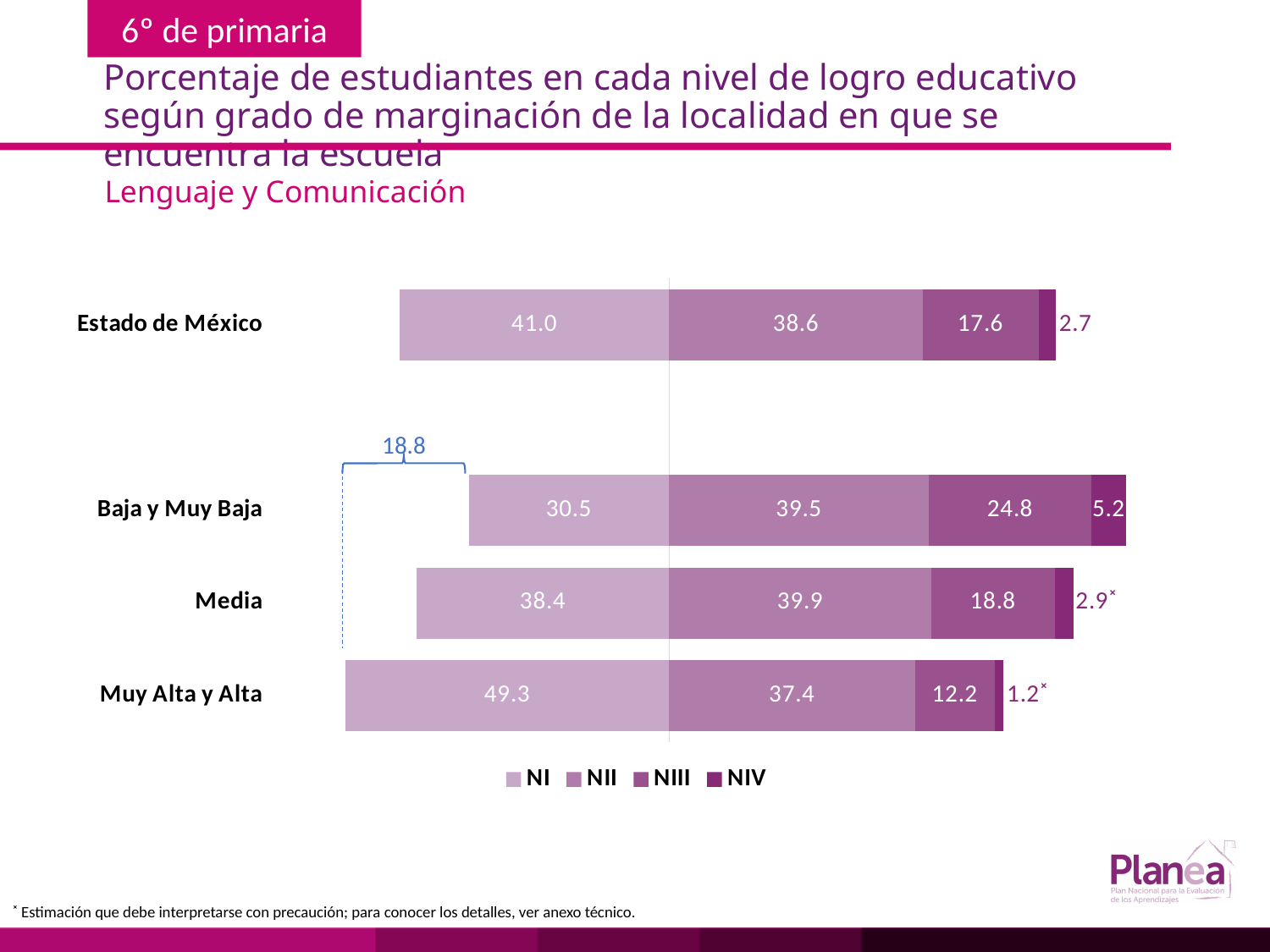
What is the NIII value for Baja y Muy Baja? 24.8 What kind of chart is shown on the slide? Stacked bar chart Which has a larger NIII value, Estado de México or Media? Media What is the NII value for Muy Alta y Alta? 37.4 Which category has the highest NI value? Muy Alta y Alta How many categories are shown on the chart? 4 What are the legend entries of the chart? NI, NII, NIII, NIV Which category has the lowest NIV value? Muy Alta y Alta What is the NI value for Estado de México? 41.0 What is the difference between the NI values for Muy Alta y Alta and Baja y Muy Baja? 18.8 How many series does the legend list? 4 What is the difference between the NII values for Media and Estado de México? 1.3